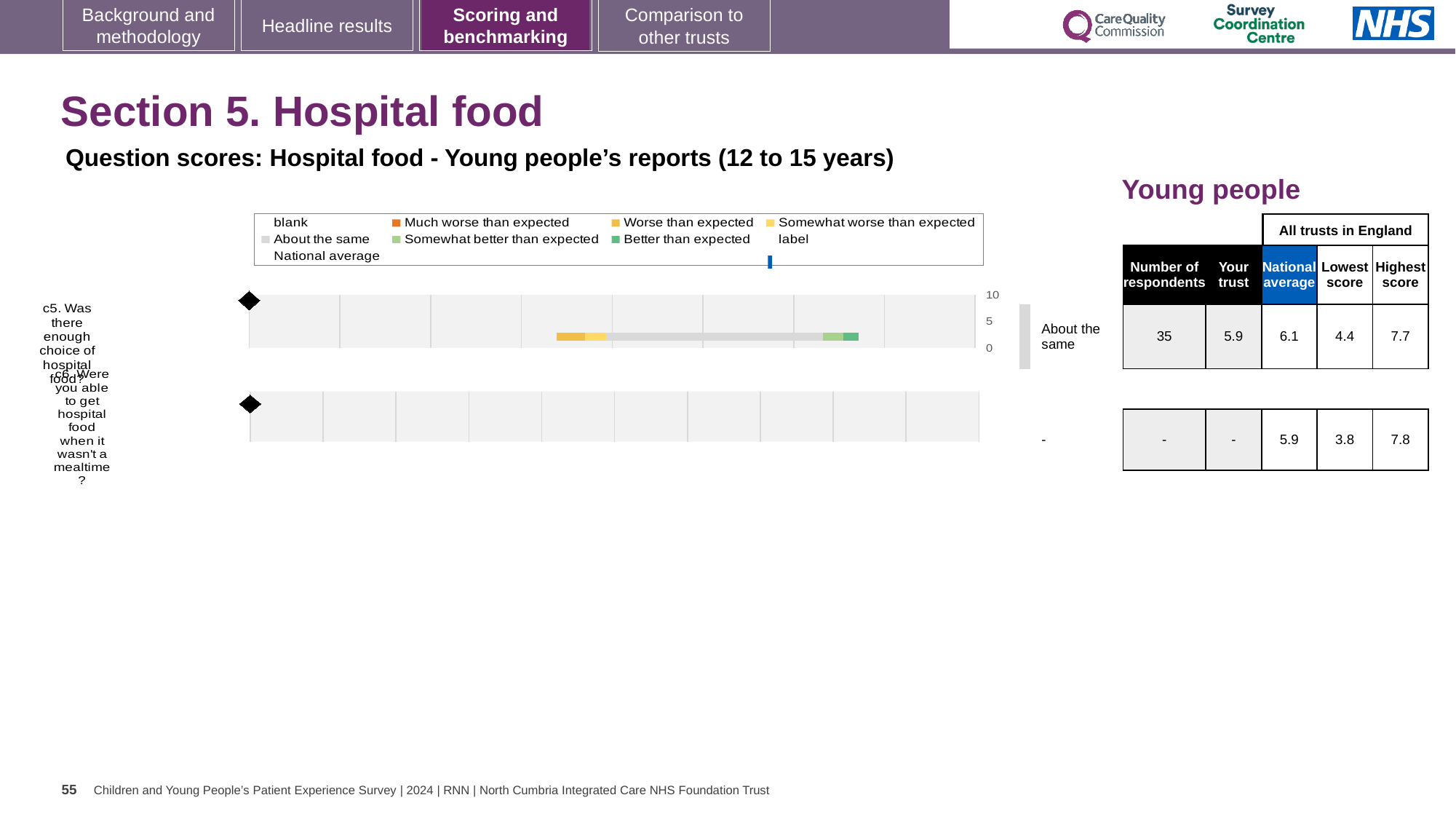
How many questions are plotted in the chart? 2 What is the highest score across all trusts in England for question c6 (Were you able to get hospital food when it wasn't a mealtime?)? 7.8 What is the 'Your trust' score for question c5 (Was there enough choice of hospital food?)? 5.9 What is the lowest score across all trusts in England for question c5 (Was there enough choice of hospital food?)? 4.4 What type of chart is shown on the slide? Bar chart What is the national average score for question c6 (Were you able to get hospital food when it wasn't a mealtime?)? 5.9 What benchmark category is given for question c5 (Was there enough choice of hospital food?)? About the same What is the difference between the highest and lowest scores for question c5 (Was there enough choice of hospital food?)? 3.3 What is the national average score for question c5 (Was there enough choice of hospital food?)? 6.1 How many respondents answered question c5 (Was there enough choice of hospital food?)? 35 Which question has the higher national average score, c5 or c6? c5 For question c5, which is larger: the 'Your trust' score or the national average? National average